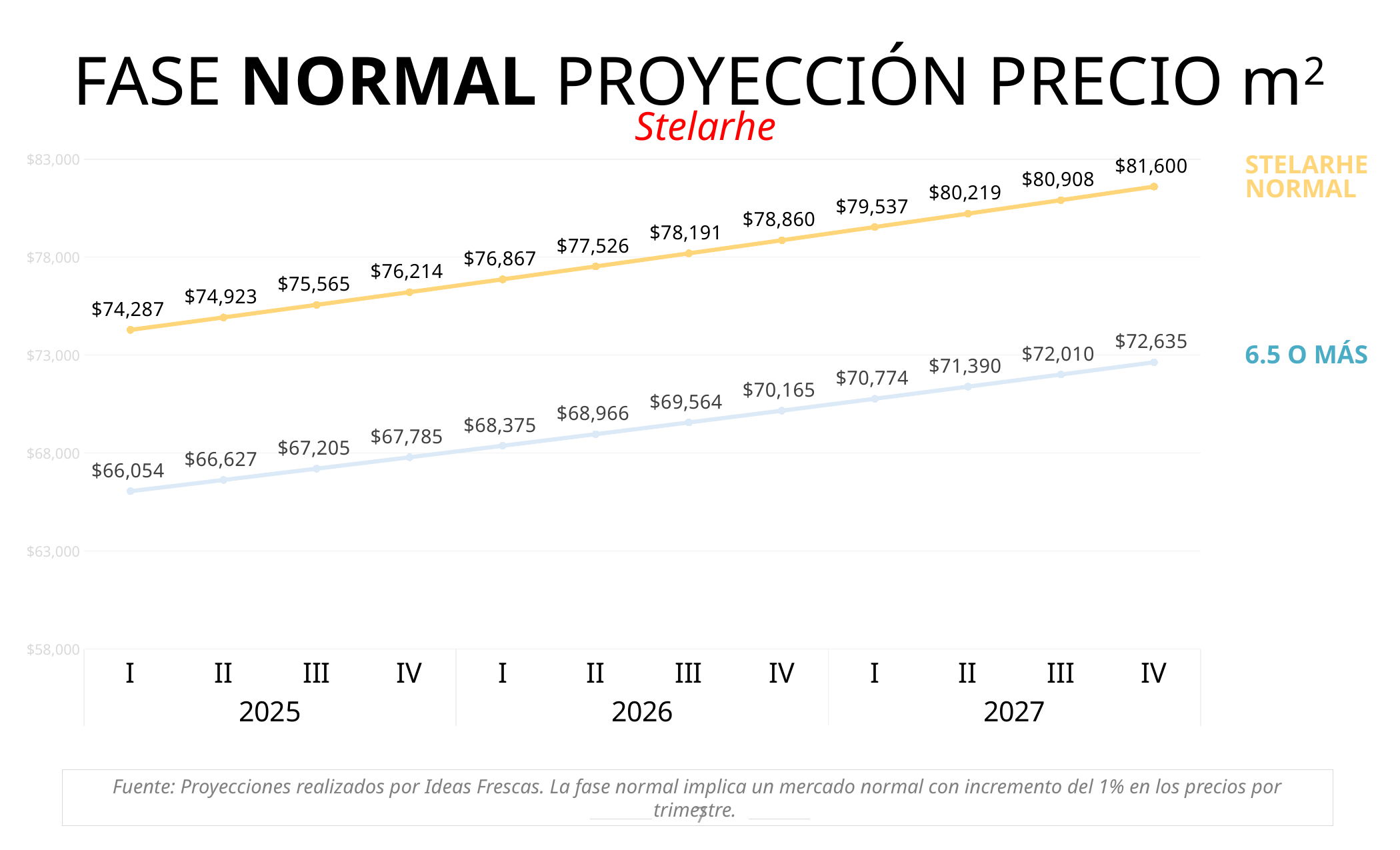
Which series has the larger value in quarter II of 2026, STELARHE NORMAL or 6.5 O MÁS? STELARHE NORMAL In which quarter and year is the 6.5 O MÁS series at its lowest value? I 2025 What type of chart is shown on the slide? Line chart How many quarterly data points does each series have? 12 What is the value of the 6.5 O MÁS series in quarter IV of 2027? $72,635 What is the value of the STELARHE NORMAL series in quarter III of 2026? $78,191 Is the value of the 6.5 O MÁS series in quarter I of 2026 greater or less than $68,000? greater In which quarter and year does the STELARHE NORMAL series reach its highest value? IV 2027 How many series are plotted on the chart? 2 What is the value of the STELARHE NORMAL series in quarter I of 2025? $74,287 What is the difference between the STELARHE NORMAL and 6.5 O MÁS values in quarter IV of 2027? $8,965 By how much does the STELARHE NORMAL series increase from quarter I of 2025 to quarter IV of 2027? $7,313